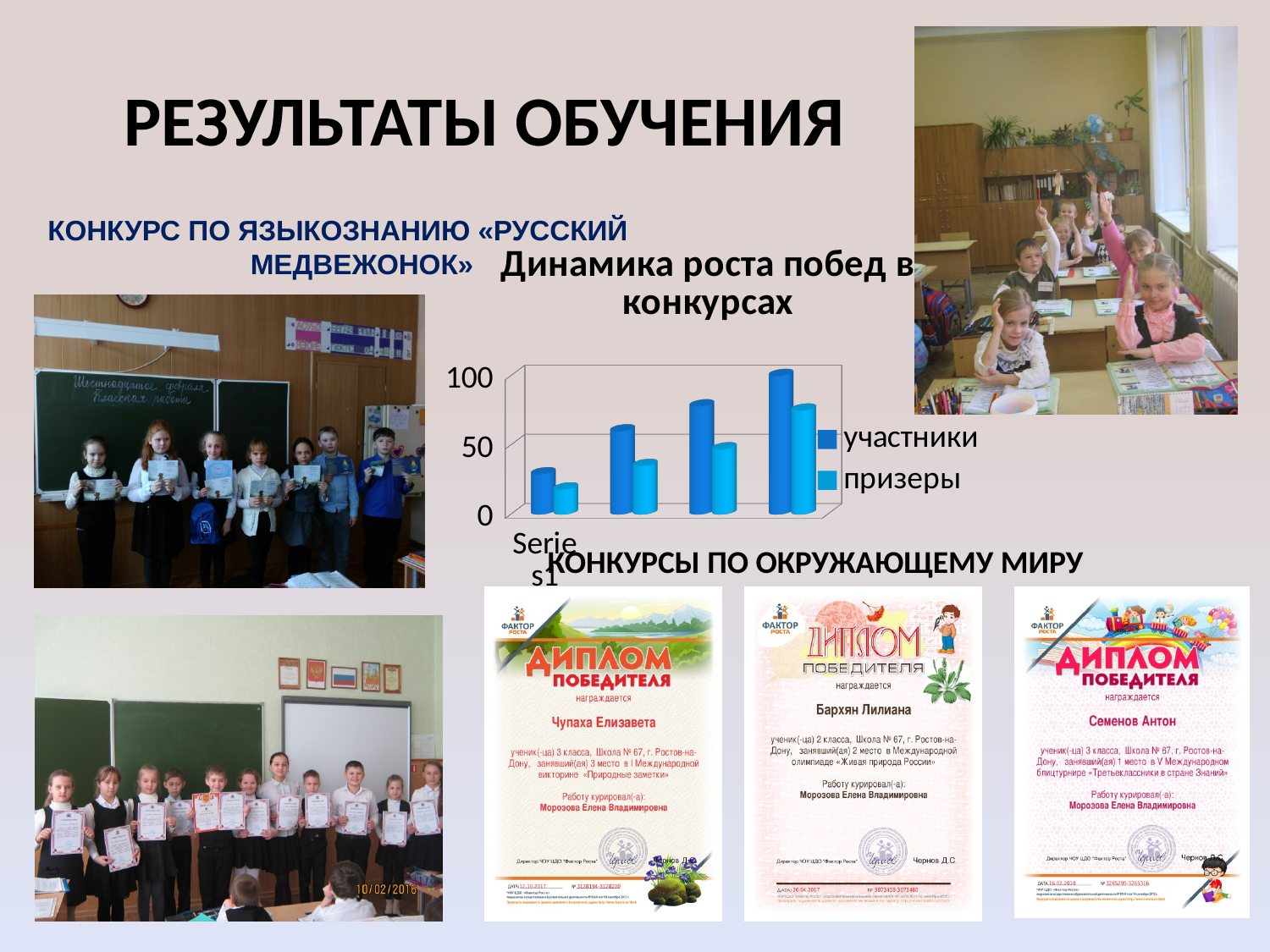
In the chart «Динамика роста побед в конкурсах», do the values for призеры rise or fall from left to right? rise How many groups of bars are plotted in the chart «Динамика роста побед в конкурсах»? 4 In the chart «Динамика роста побед в конкурсах», which series has the taller bar in the rightmost group, участники or призеры? участники What is the title of the chart on the slide? Динамика роста побед в конкурсах How many series does the legend of the chart «Динамика роста побед в конкурсах» list? 2 In the chart «Динамика роста побед в конкурсах», which group of bars has the highest участники value? the last (rightmost) group In the chart «Динамика роста побед в конкурсах», is the участники value for the last (rightmost) group greater or less than 50? greater In the chart «Динамика роста побед в конкурсах», do the values for участники rise or fall from left to right? rise What are the two series named in the legend of the chart «Динамика роста побед в конкурсах»? участники, призеры In the chart «Динамика роста побед в конкурсах», is the призеры value for the first (leftmost) group greater or less than 50? less What kind of chart is shown under the title «Динамика роста побед в конкурсах»? bar chart In the chart «Динамика роста побед в конкурсах», is the участники value for the first (leftmost) group greater or less than 50? less